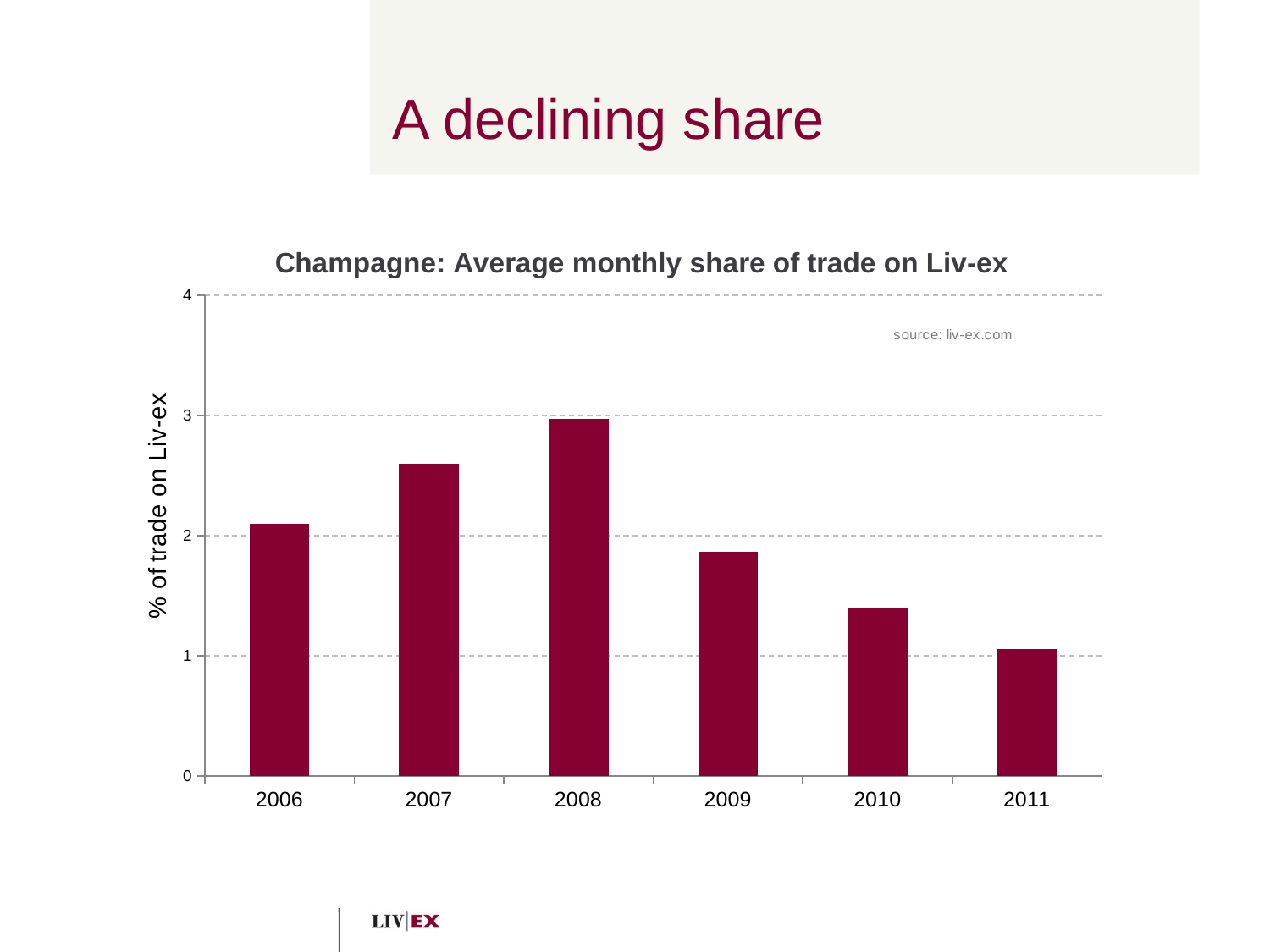
How do the values change from 2008 to 2011? they fall Is the value for 2010 greater or less than 1? greater Which year has the larger share of trade, 2007 or 2009? 2007 Which year has the highest average monthly share of trade on Liv-ex? 2008 How many years are shown on the x axis of the chart? 6 Is the value for 2009 greater or less than 2? less Is the value for 2006 greater or less than 2? greater What is the title of the chart? Champagne: Average monthly share of trade on Liv-ex What kind of chart is shown on the slide? bar chart Which year has the lowest average monthly share of trade on Liv-ex? 2011 Which year has the larger share of trade, 2010 or 2006? 2006